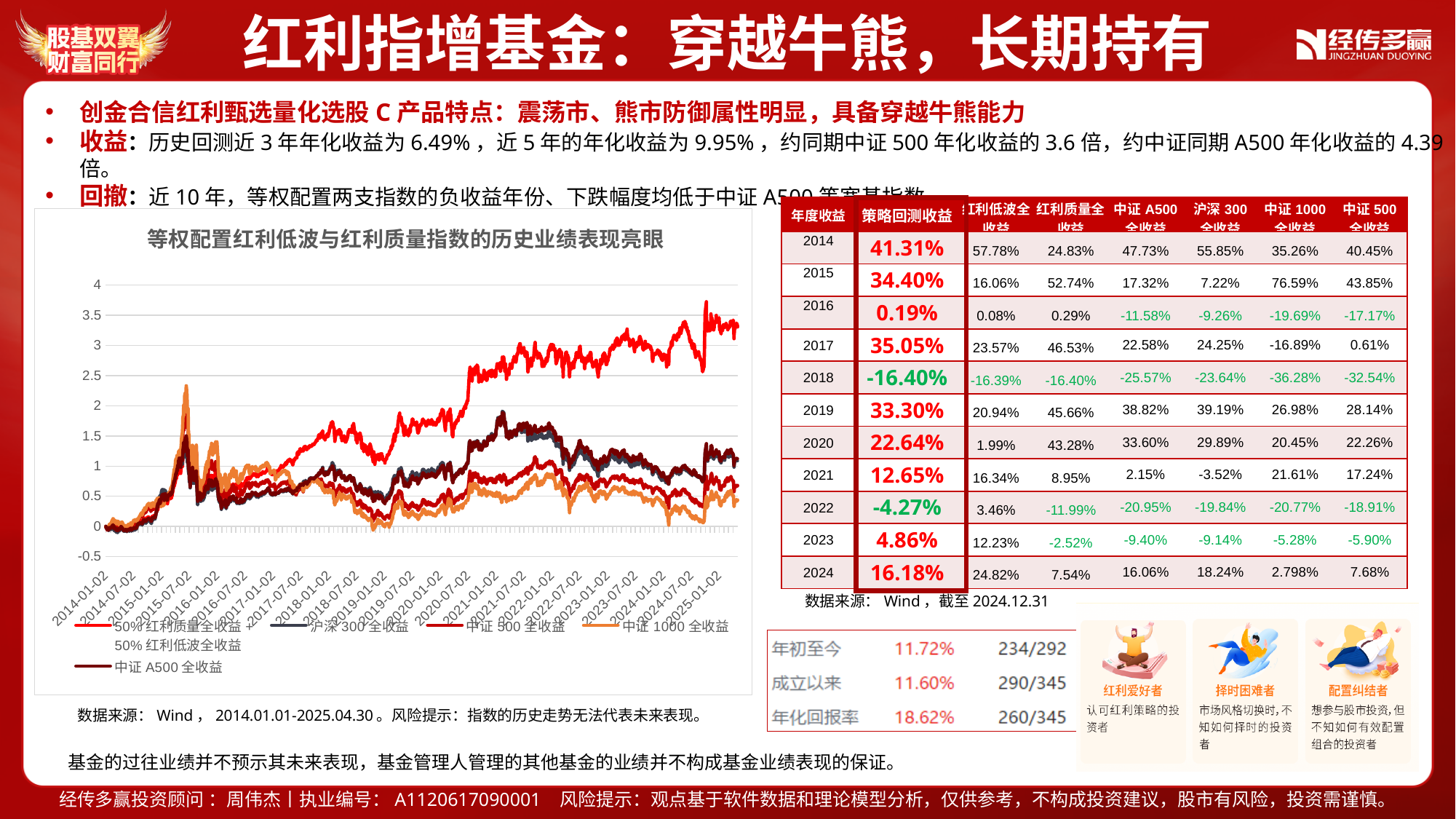
In the line chart, is the value of the 中证1000全收益 series at 2025-01-02 greater or less than 1? less What is the highest tick value shown on the y axis of the line chart? 4 In the line chart, is the peak value of the 50%红利质量全收益 50%红利低波全收益 series in 2024 greater or less than 3.5? greater In the line chart, which series is larger at 2025-01-02: 50%红利质量全收益 50%红利低波全收益 or 中证500全收益? 50%红利质量全收益 50%红利低波全收益 How many series does the legend of the line chart list? 5 What kind of chart is shown on the left of the slide? line chart In the line chart, is the value of the 50%红利质量全收益 50%红利低波全收益 series at 2025-01-02 greater or less than 2? greater In the line chart, which series is highest at the end of the period (2025-01-02)? 50%红利质量全收益 50%红利低波全收益 What is the title of the line chart? 等权配置红利低波与红利质量指数的历史业绩表现亮眼 In the line chart, which series is lowest at the end of the period (2025-01-02)? 中证1000全收益 In the line chart, does the 50%红利质量全收益 50%红利低波全收益 series rise or fall overall from 2014 to 2025? rise